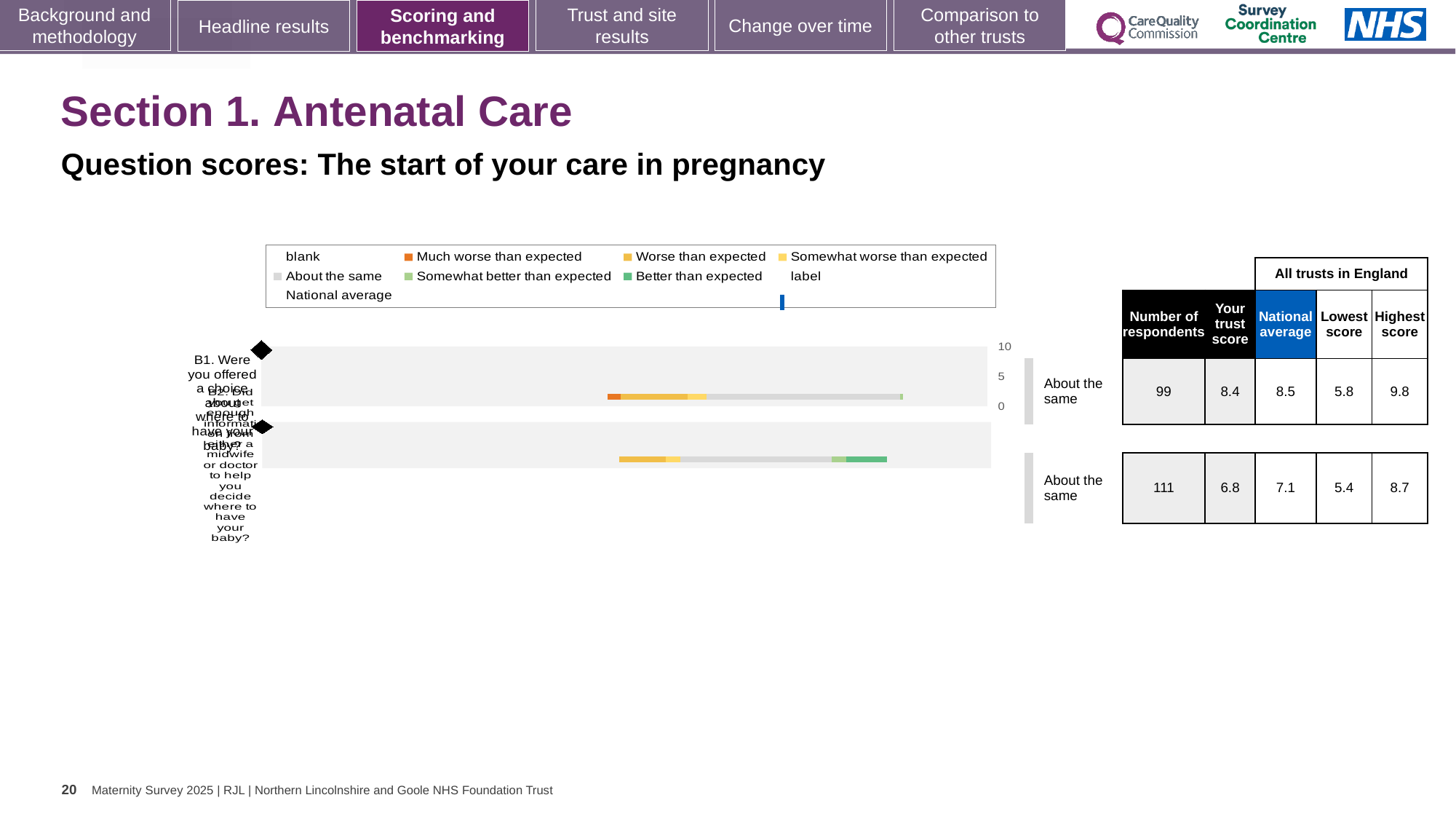
What type of chart is used to show the question scores? Bar chart What is the difference between the highest score and the lowest score for question B1? 4.0 Which question has the higher trust score, B1 or B2? B1 By how much does the national average exceed the trust score for question B2? 0.3 What is the 'Your trust score' for question B1 (Were you offered a choice about where to have your baby?)? 8.4 What is the lowest score among all trusts in England for question B2? 5.4 For question B2, which is larger: the trust score or the national average? National average How many questions are plotted in the chart? 2 How many respondents answered question B2 (Did you get enough information from either a midwife or doctor to help you decide where to have your baby?)? 111 What is the highest score among all trusts in England for question B2? 8.7 What benchmark category is shown for question B1? About the same What is the national average score for question B1? 8.5